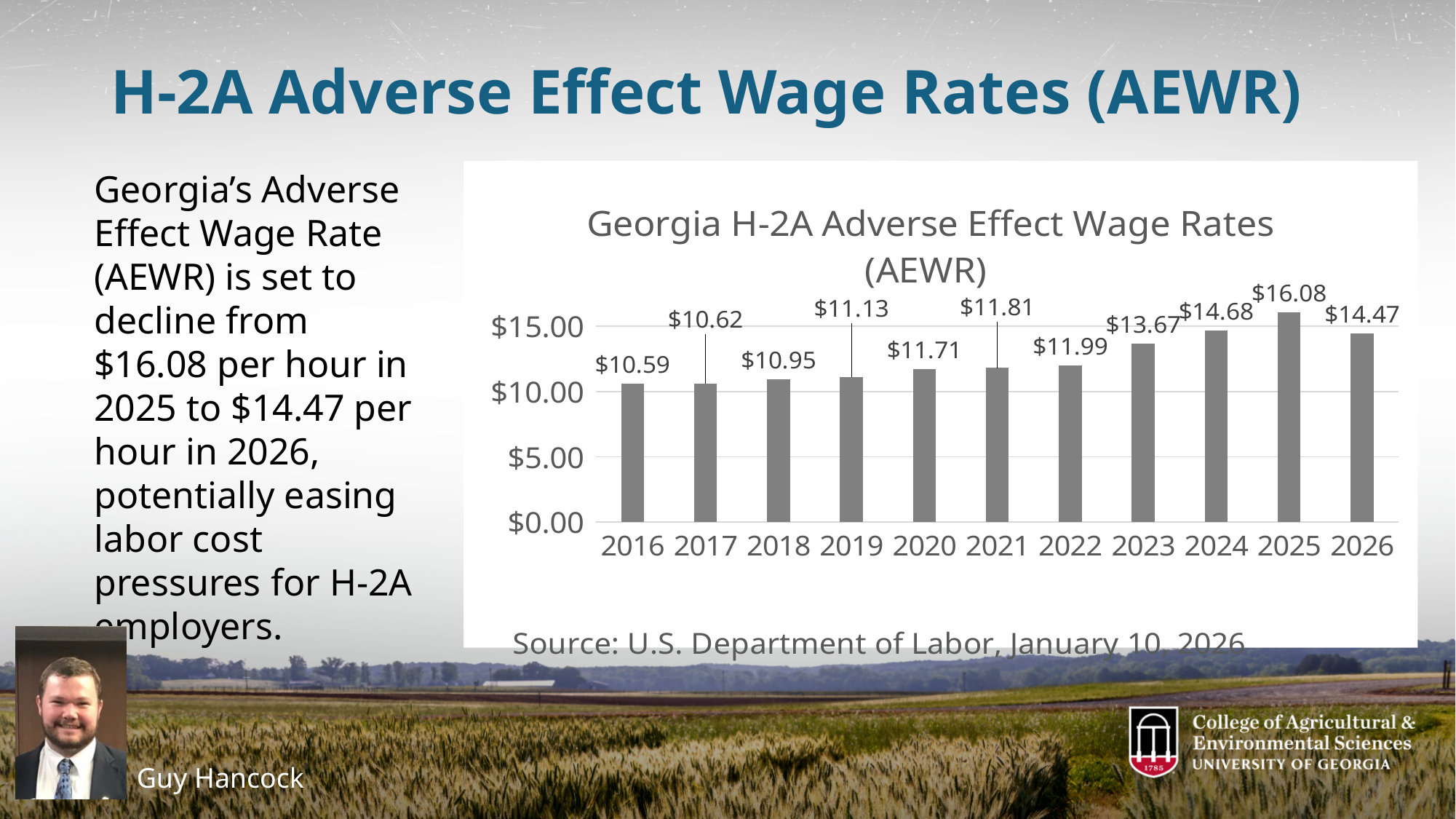
Do the AEWR values generally rise or fall from 2016 to 2025? rise What is the Georgia H-2A AEWR value for 2016? $10.59 What is the title of the chart? Georgia H-2A Adverse Effect Wage Rates (AEWR) Which year has the highest AEWR in the chart? 2025 Which year has the lowest AEWR in the chart? 2016 Which year has a higher AEWR, 2023 or 2024? 2024 What kind of chart is shown on the slide? bar chart Is the value for 2021 greater or less than $15.00? less How many years are shown on the x axis of the chart? 11 What is the difference between the AEWR in 2025 and in 2026? $1.61 What is the Georgia H-2A AEWR value for 2022? $11.99 What is the Georgia H-2A AEWR value for 2025? $16.08